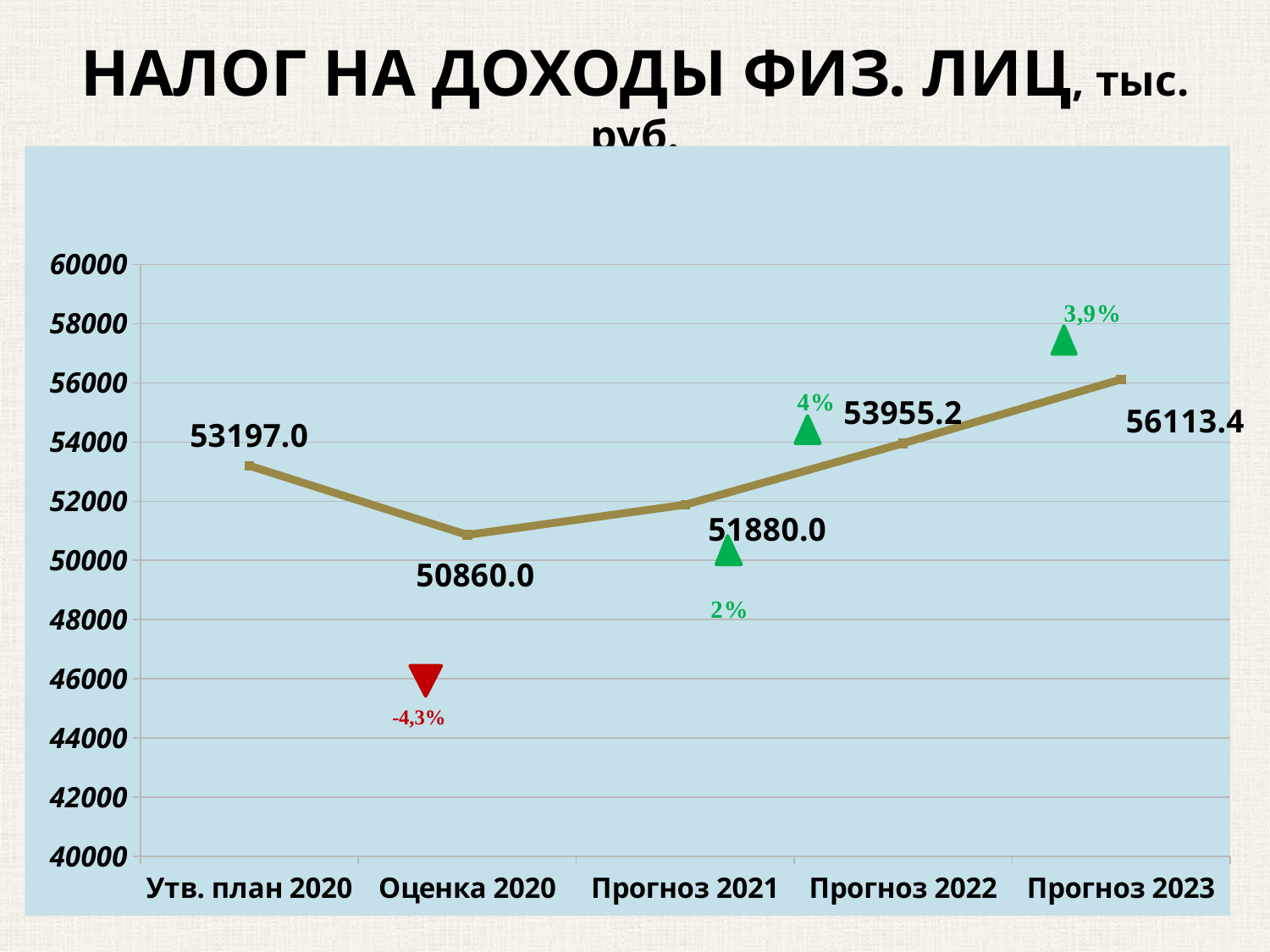
What is the value for Прогноз 2023? 56113.4 What type of chart is shown on the slide? line chart What is the difference between the values for Утв. план 2020 and Оценка 2020? 2337.0 How many categories are shown on the x axis? 5 Which is larger, the value for Прогноз 2021 or the value for Прогноз 2022? Прогноз 2022 Which category has the highest value? Прогноз 2023 What is the value for Утв. план 2020? 53197.0 What percentage change is marked next to the red downward triangle? -4,3% What is the value for Оценка 2020? 50860.0 What is the difference between the values for Прогноз 2023 and Утв. план 2020? 2916.4 What is the value for Прогноз 2022? 53955.2 Which category has the lowest value? Оценка 2020